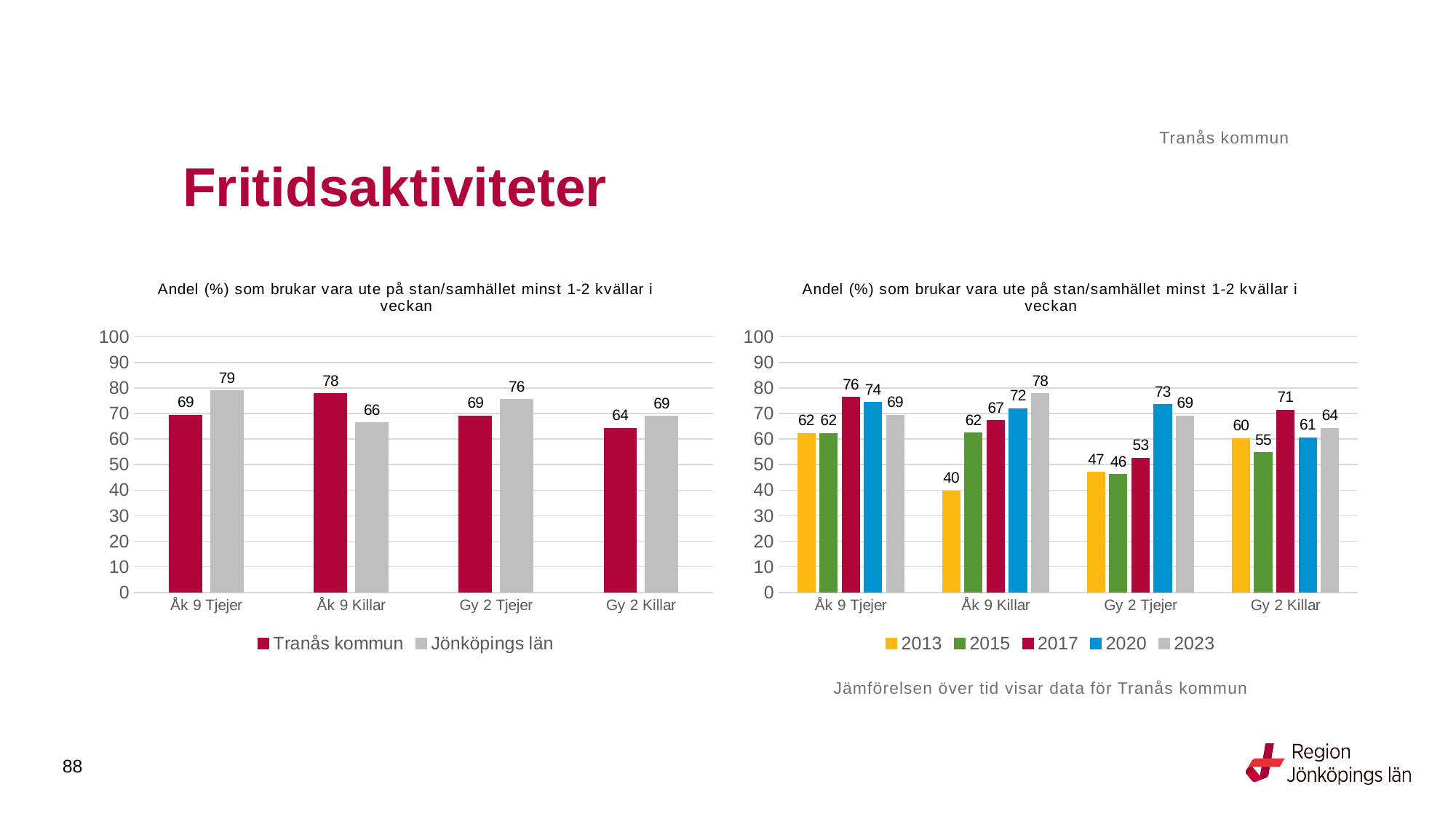
How many series does the legend of the right chart list? 5 In the right chart, what is the value for 2013 for Åk 9 Killar? 40 In the right chart, what is the value for 2020 for Gy 2 Tjejer? 73 In the right chart, what is the difference between the 2023 and 2013 values for Åk 9 Killar? 38 In the left chart, what is the difference between Tranås kommun and Jönköpings län for Åk 9 Killar? 12 What type of chart is the left chart? Bar chart In the left chart, which is larger for Gy 2 Killar: Tranås kommun or Jönköpings län? Jönköpings län In the left chart, what is the value for Tranås kommun for Åk 9 Killar? 78 In the left chart, which category has the highest value for Jönköpings län? Åk 9 Tjejer In the left chart, what is the value for Jönköpings län for Gy 2 Tjejer? 76 In the right chart, which category has the lowest value for 2015? Gy 2 Tjejer How many categories are shown on the x axis of the right chart? 4